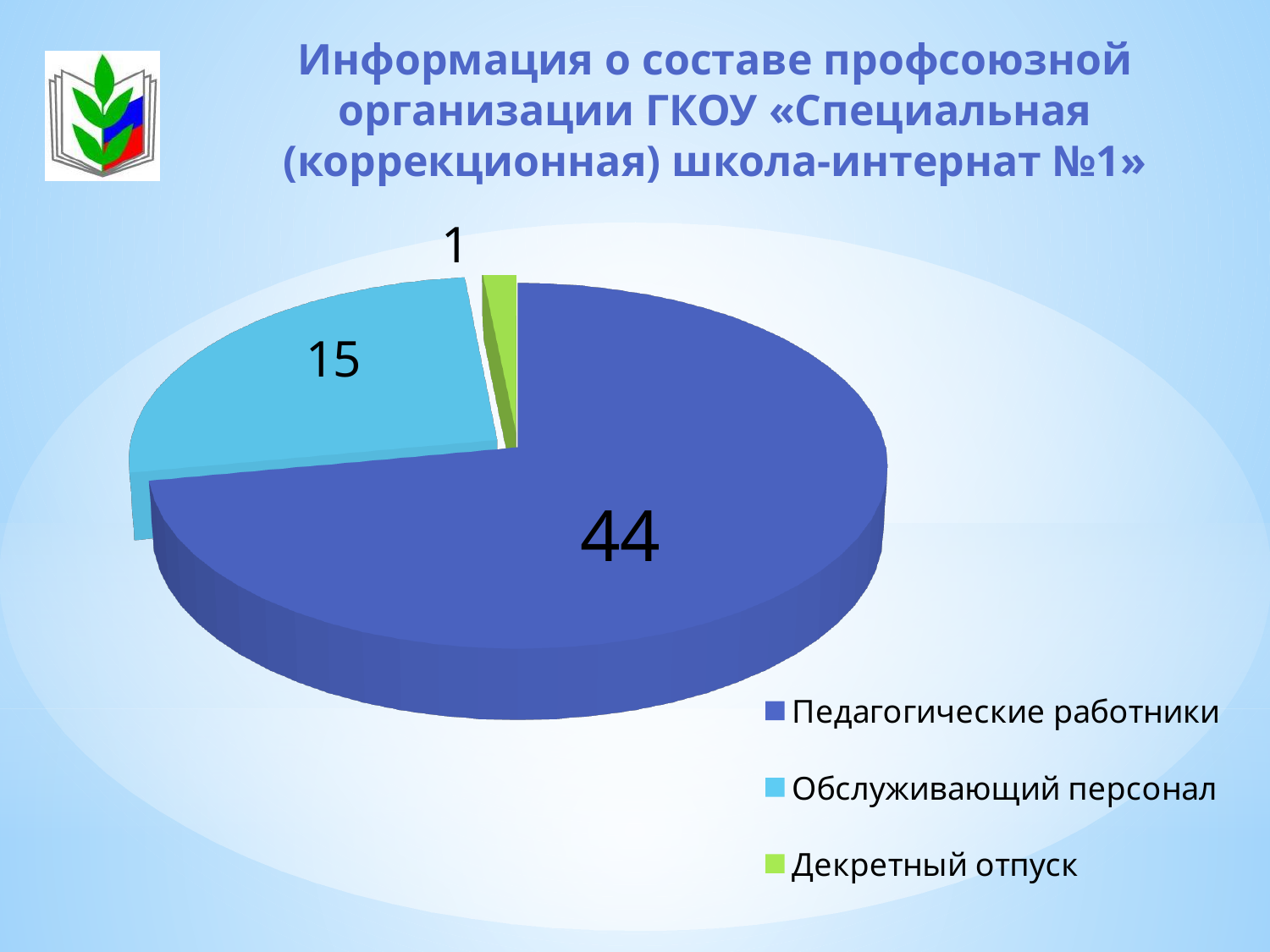
What share of the pie does Обслуживающий персонал represent? 25% Which is larger, the value for Обслуживающий персонал or the value for Декретный отпуск? Обслуживающий персонал What is the difference between the values for Педагогические работники and Обслуживающий персонал? 29 Which category has the smallest slice of the pie? Декретный отпуск What colour is the slice for Декретный отпуск? green What is the value for Декретный отпуск? 1 What is the value for Педагогические работники? 44 What kind of chart is shown on the slide? pie chart How many slices does the pie chart have? 3 What is the value for Обслуживающий персонал? 15 Which category has the largest slice of the pie? Педагогические работники What is the total of all slices in the pie chart? 60